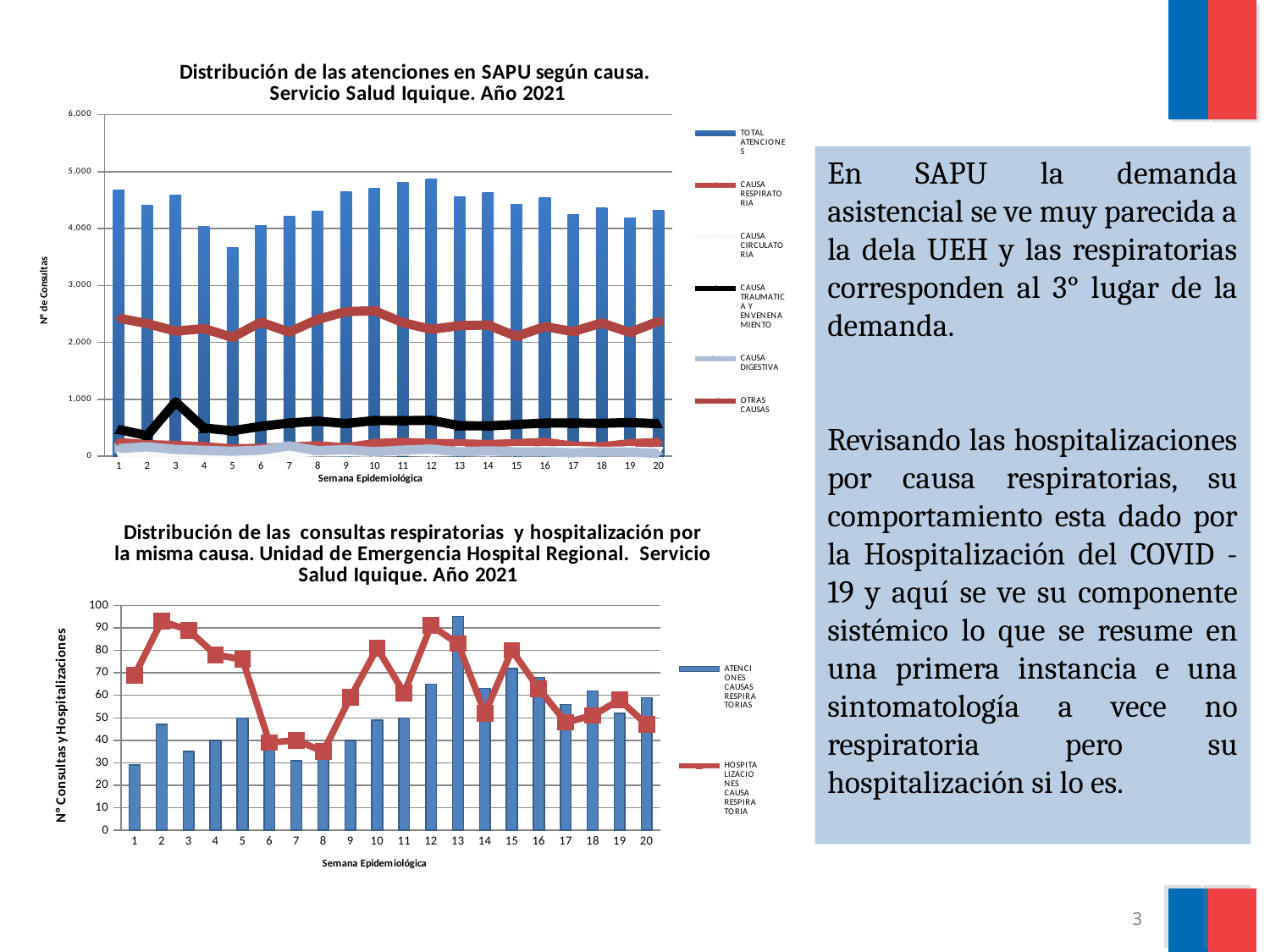
How many series does the legend of the top chart (atenciones en SAPU según causa) list? 6 What type of chart is the top chart, 'Distribución de las atenciones en SAPU según causa'? Combined bar and line chart In the bottom chart (consultas respiratorias y hospitalización), is the ATENCIONES CAUSAS RESPIRATORIAS value for week 1 greater or less than 40? less In the top chart (atenciones en SAPU según causa), is the CAUSA RESPIRATORIA value for week 10 greater or less than 2,000? less In the top chart (atenciones en SAPU según causa), in which week does the CAUSA TRAUMATICA Y ENVENENAMIENTO line reach its highest point? 3 How many epidemiological weeks are plotted on the x axis of the top chart (atenciones en SAPU según causa)? 20 In the top chart (atenciones en SAPU según causa), which week has the lowest TOTAL ATENCIONES bar? 5 In the top chart (atenciones en SAPU según causa), is the TOTAL ATENCIONES value for week 5 greater or less than 4,000? less How many series does the legend of the bottom chart (consultas respiratorias y hospitalización) list? 2 In the bottom chart (consultas respiratorias y hospitalización), which is larger: the ATENCIONES CAUSAS RESPIRATORIAS bar for week 13 or for week 1? Week 13 In the bottom chart (consultas respiratorias y hospitalización), which week has the highest ATENCIONES CAUSAS RESPIRATORIAS bar? 13